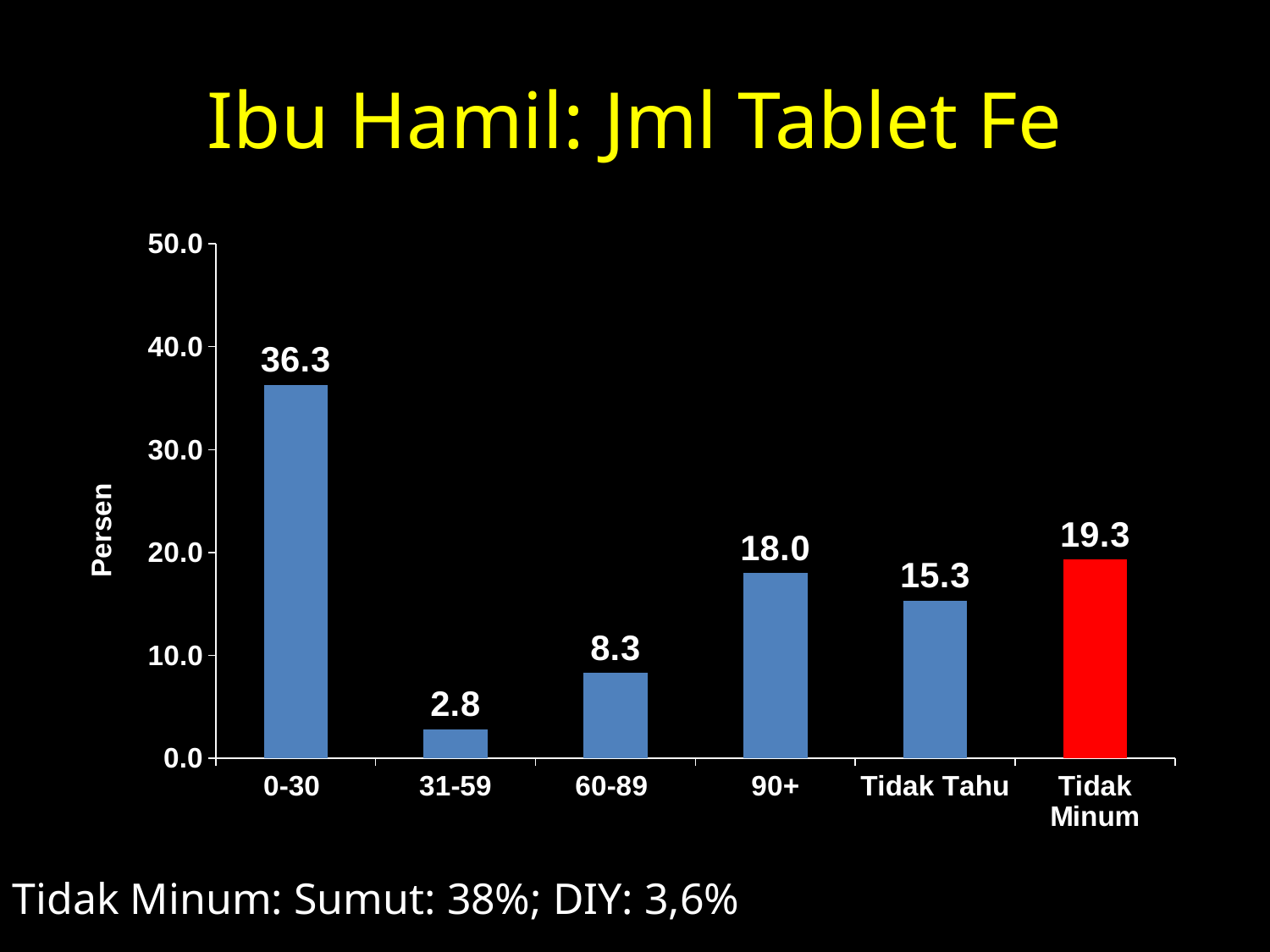
What is the value for the 0-30 category? 36.3 Which bar is coloured red? Tidak Minum What is the difference between the values for Tidak Minum and Tidak Tahu? 4.0 What kind of chart is shown on the slide? bar chart What is the difference between the values for 0-30 and 31-59? 33.5 Which category has the highest value? 0-30 Is the value for 0-30 greater or less than 30.0? greater How many categories are shown on the x axis? 6 What is the value for the Tidak Minum category? 19.3 What is the value for the 60-89 category? 8.3 Which category has the lowest value? 31-59 Which is larger, the value for 90+ or the value for Tidak Tahu? 90+